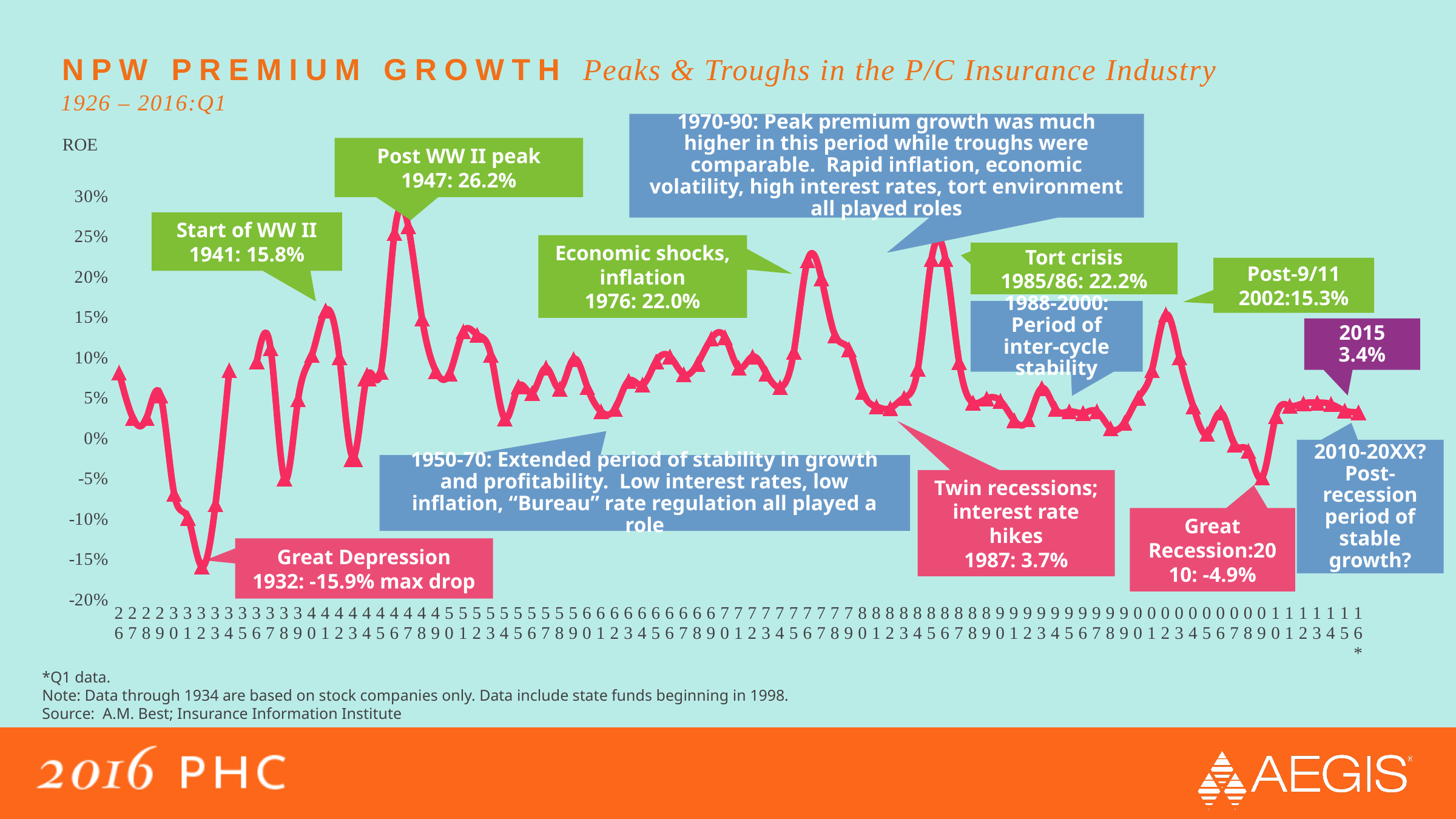
What label is shown on the vertical axis of the chart? ROE By how many percentage points does the 1947 peak (26.2%) exceed the 1941 value (15.8%)? 10.4 percentage points Which year had the higher NPW premium growth, 1947 or 2002? 1947 What was the NPW premium growth value in 2002, post-9/11? 15.3% What was the NPW premium growth value in 1976? 22.0% What kind of chart is shown on the slide? line chart What was the NPW premium growth value in 2015? 3.4% What was the maximum drop in NPW premium growth during the Great Depression in 1932? -15.9% What was the NPW premium growth value in 1941 at the start of WW II? 15.8% What was the NPW premium growth value at the post-WW II peak in 1947? 26.2% What was the NPW premium growth value during the Great Recession in 2010? -4.9% Is the NPW premium growth value for 1932 greater or less than -15%? less